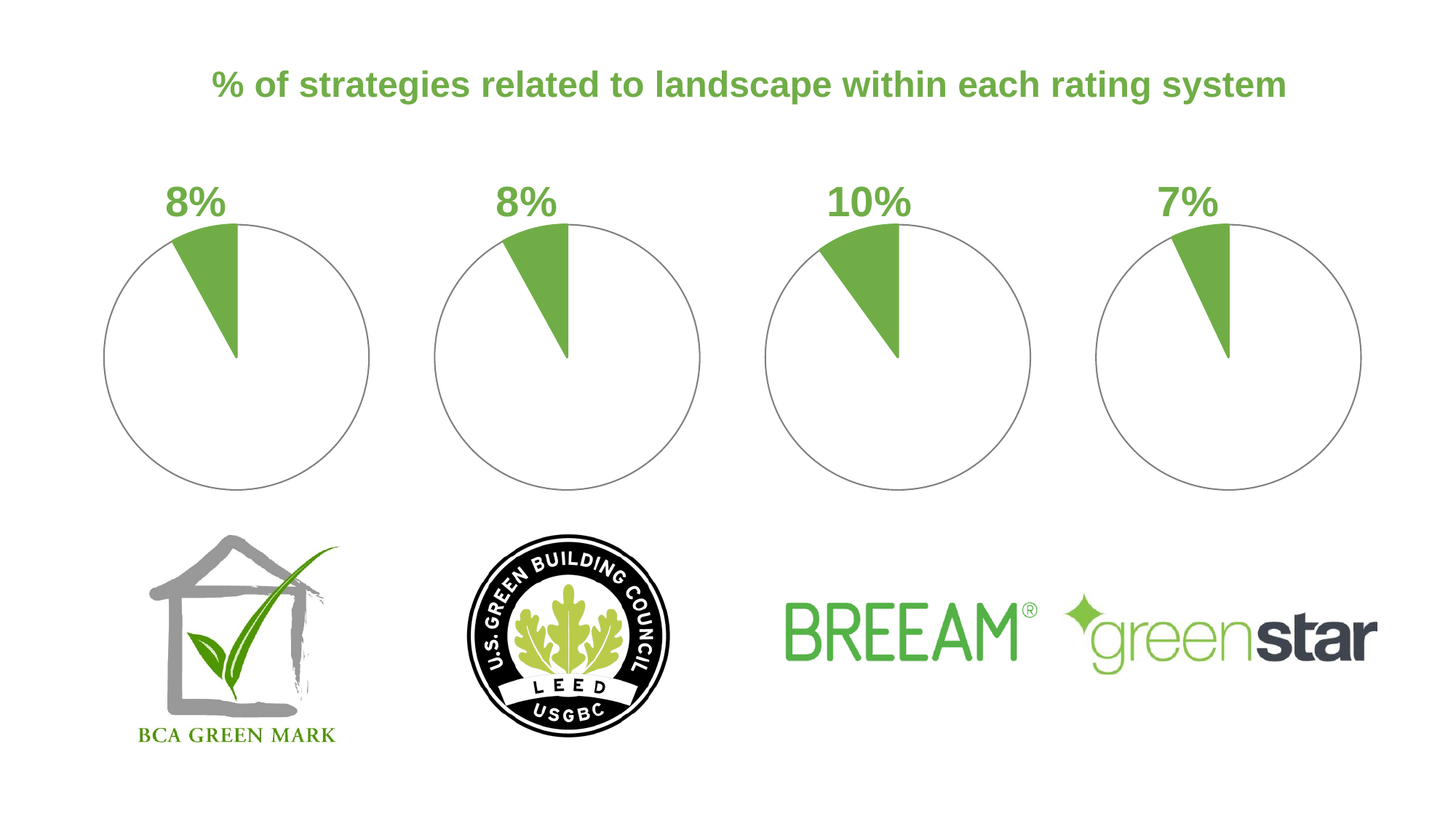
What kind of chart is used to show each rating system's percentage? Pie chart What percentage of strategies are related to landscape in the BREEAM rating system? 10% What percentage of strategies are related to landscape in the BCA Green Mark rating system? 8% Which rating system has the highest percentage of strategies related to landscape? BREEAM What is the difference between the BREEAM percentage and the Green Star percentage? 3% Which has a larger percentage of landscape-related strategies, BREEAM or BCA Green Mark? BREEAM What percentage of strategies are related to landscape in the Green Star rating system? 7% What is the difference between the BREEAM percentage and the LEED percentage? 2% What percentage of strategies are related to landscape in the LEED rating system? 8% How many rating systems are shown on the slide? 4 Which rating system has the lowest percentage of strategies related to landscape? Green Star What is the title of the slide's charts? % of strategies related to landscape within each rating system